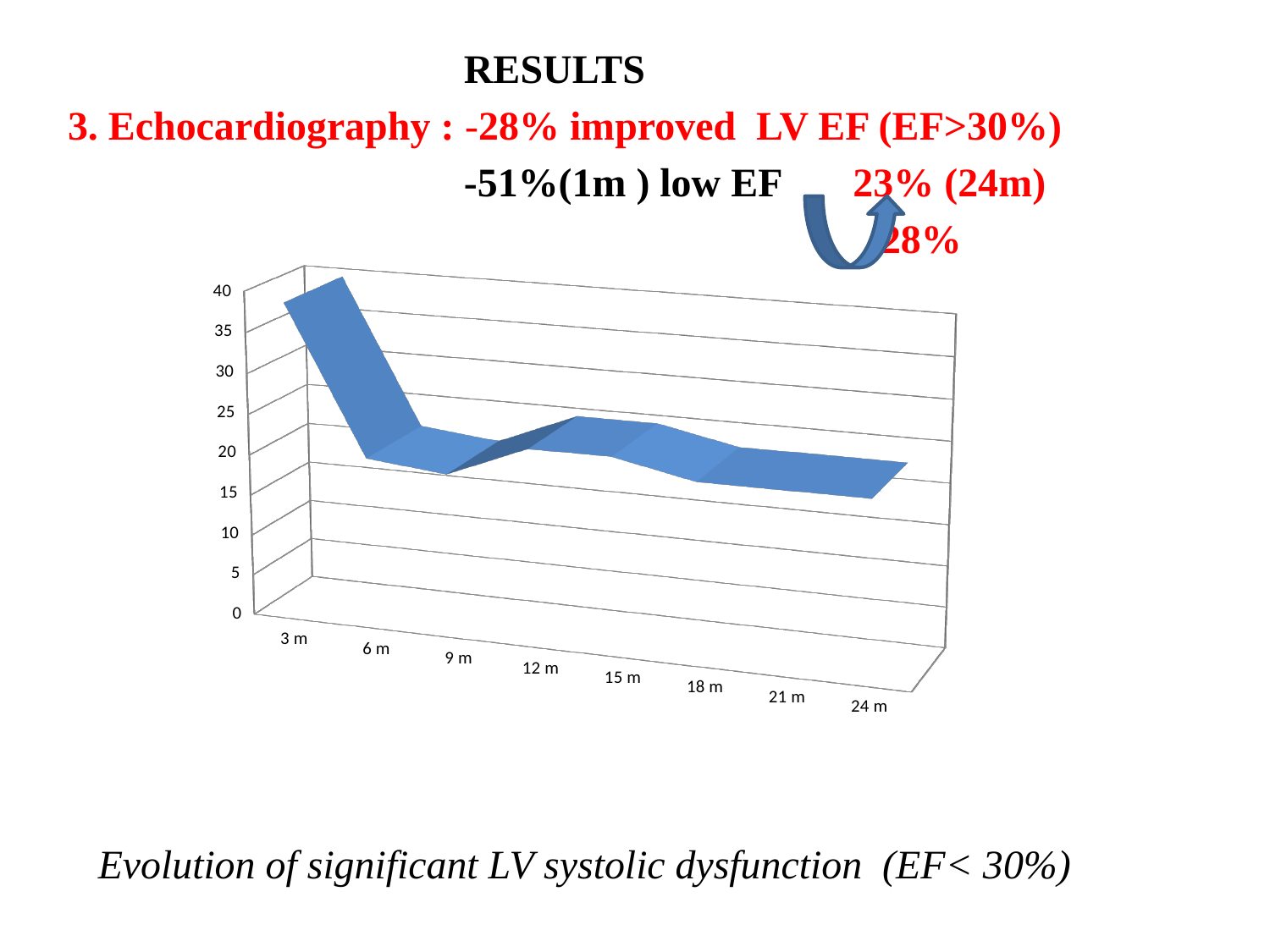
What is the maximum value shown on the y axis of the chart? 40 How many time points are shown along the x axis of the chart? 8 Do the values generally rise or fall from 3 m to 24 m? fall Is the value at 3 m greater or less than 30? greater What kind of chart is shown on the slide? 3D line chart Is the value at 24 m greater or less than 30? less Which time point has the highest value in the chart? 3 m Which is larger, the value at 3 m or the value at 6 m? 3 m Is the value at 6 m greater or less than 35? less What is the first time point label on the x axis? 3 m